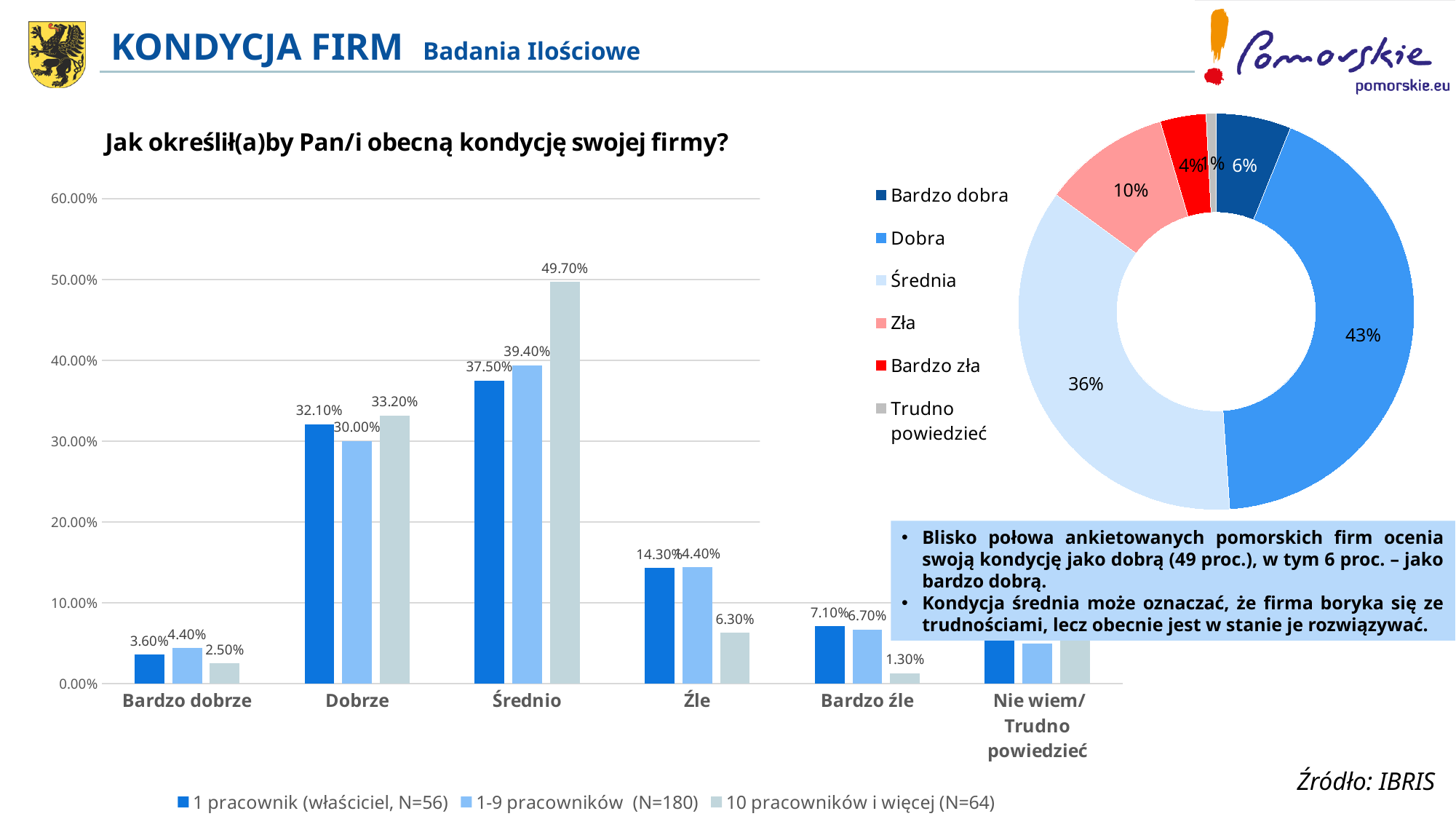
How many series does the legend of the bar chart list? 3 How many categories does the legend of the donut chart on the right list? 6 In the bar chart, which category has the highest value for the series 10 pracowników i więcej (N=64)? Średnio In the donut chart on the right, which category has the smallest share? Trudno powiedzieć In the bar chart, what is the value for Dobrze for the series 1 pracownik (właściciel, N=56)? 32.10% In the bar chart, is the value for Dobrze for the series 1-9 pracowników (N=180) greater or less than 20.00%? greater What kind of chart is the chart on the left of the slide? bar chart In the bar chart, for Źle, which series has the larger value: 1-9 pracowników (N=180) or 10 pracowników i więcej (N=64)? 1-9 pracowników (N=180) In the donut chart on the right, what share does Dobra have? 43% In the bar chart, what is the difference between the 10 pracowników i więcej (N=64) value and the 1 pracownik (właściciel, N=56) value for Średnio? 12.20% In the bar chart, what is the value for Bardzo źle for the series 1-9 pracowników (N=180)? 6.70% In the bar chart, what is the value for Średnio for the series 10 pracowników i więcej (N=64)? 49.70%